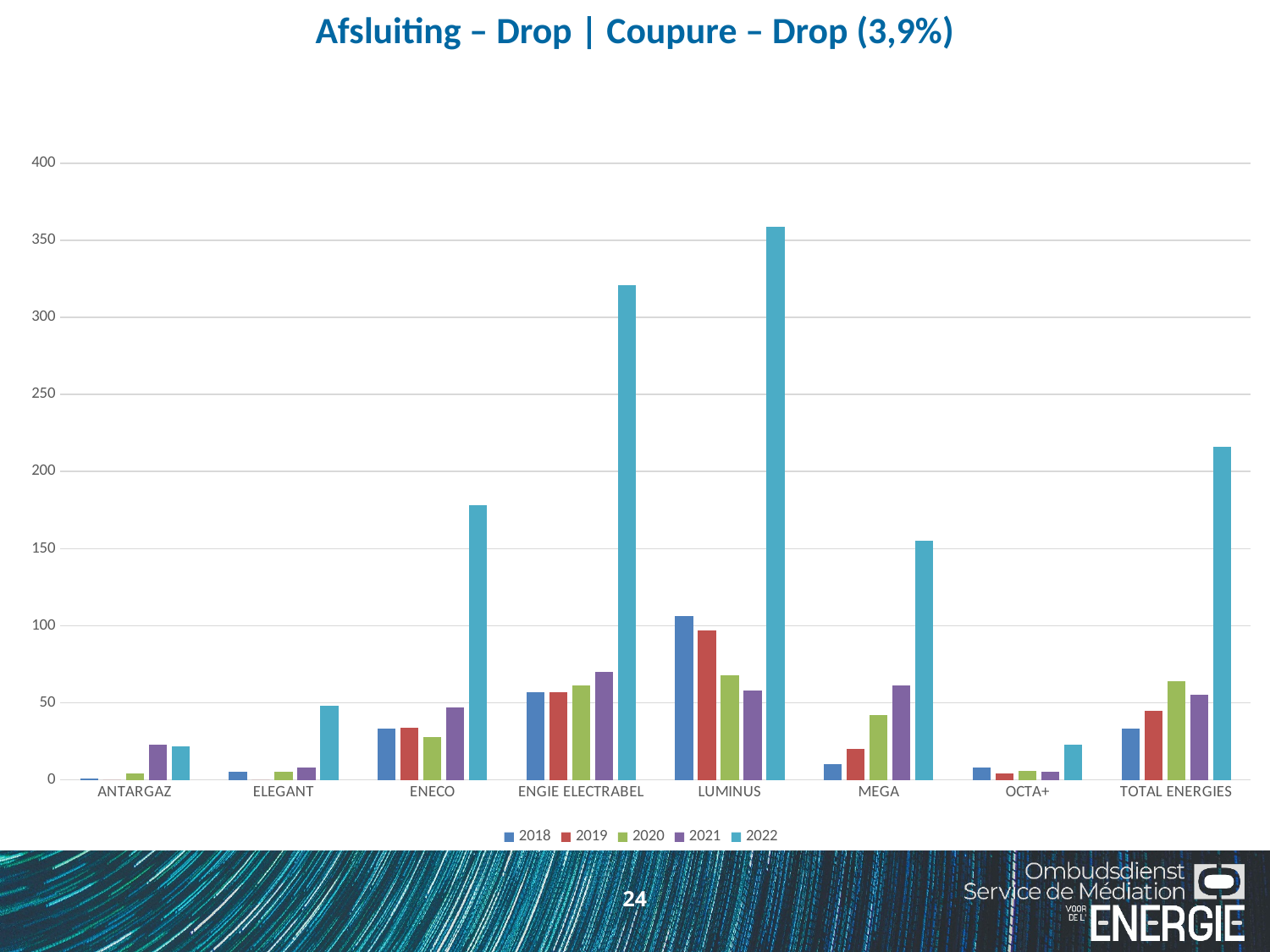
How many supplier categories are shown on the x axis? 8 Which is larger: the 2022 value for ENECO or the 2022 value for TOTAL ENERGIES? TOTAL ENERGIES Is the 2022 value for ELEGANT greater or less than 100? less Is the 2022 value for ENECO greater or less than 150? greater What kind of chart is shown on the slide? bar chart What is the title of the chart? Afsluiting – Drop | Coupure – Drop (3,9%) Which supplier has the highest 2022 bar? LUMINUS How many series does the legend list? 5 Is the 2022 value for ENGIE ELECTRABEL greater or less than 300? greater Which supplier has the highest 2018 bar? LUMINUS Do the values for LUMINUS rise or fall from 2018 to 2021? fall